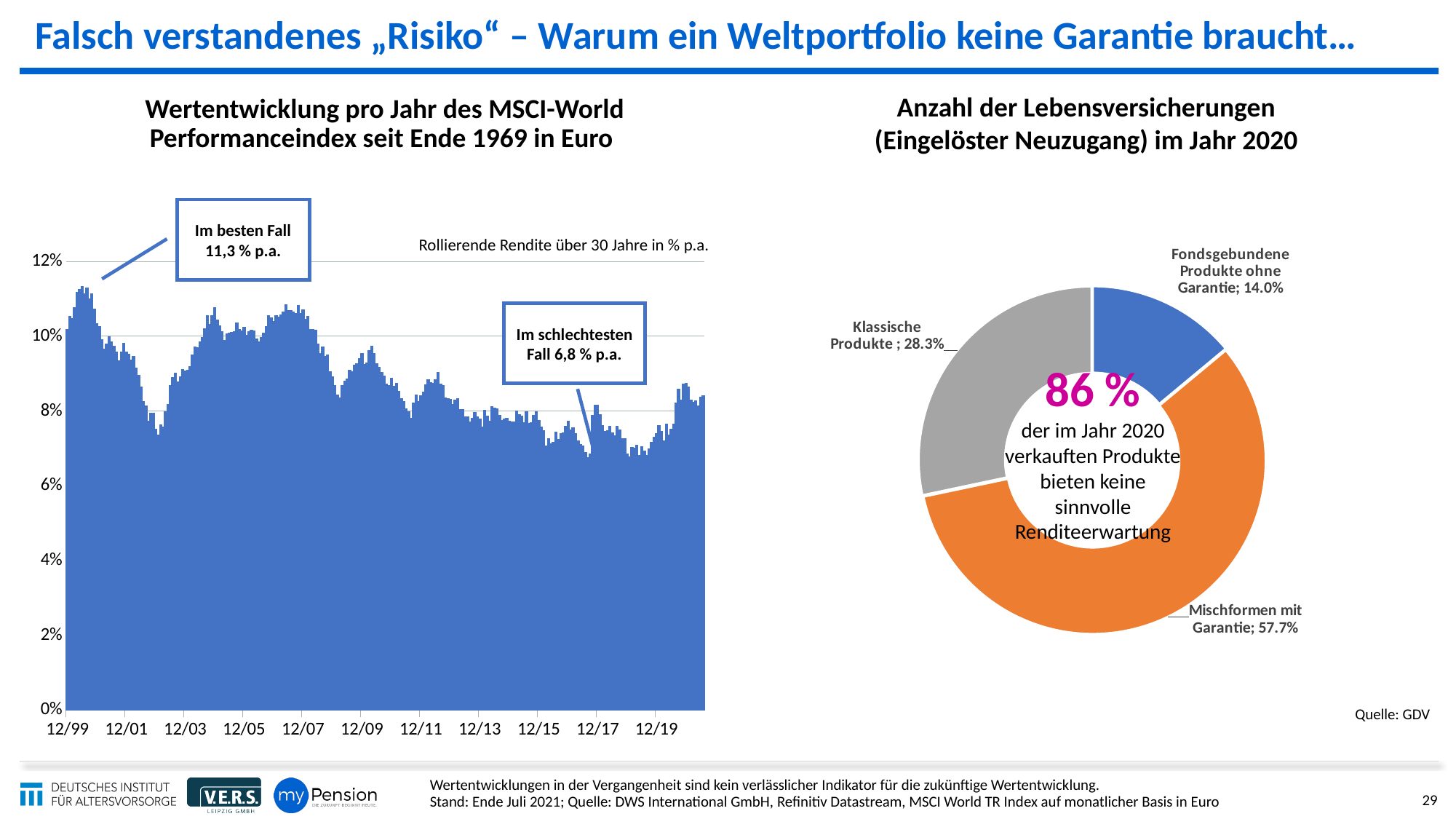
On the right chart, what share do Fondsgebundene Produkte ohne Garantie have? 14.0% What kind of chart is the right chart? Doughnut chart On the left chart, is the value at 12/01 greater or less than 8%? greater On the left chart, what is the rolling 30-year return in the worst case according to the annotation? 6,8 % p.a. On the right chart, which category has the smallest share? Fondsgebundene Produkte ohne Garantie On the right chart, what is the difference in percentage points between Mischformen mit Garantie and Klassische Produkte? 29.4 On the left chart (Wertentwicklung pro Jahr des MSCI-World), what is the rolling 30-year return in the best case according to the annotation? 11,3 % p.a. On the right chart, what share do Klassische Produkte have? 28.3% On the right chart, how many categories are shown? 3 On the right chart (Anzahl der Lebensversicherungen), what share do Mischformen mit Garantie have? 57.7% On the right chart, which category has the largest share? Mischformen mit Garantie